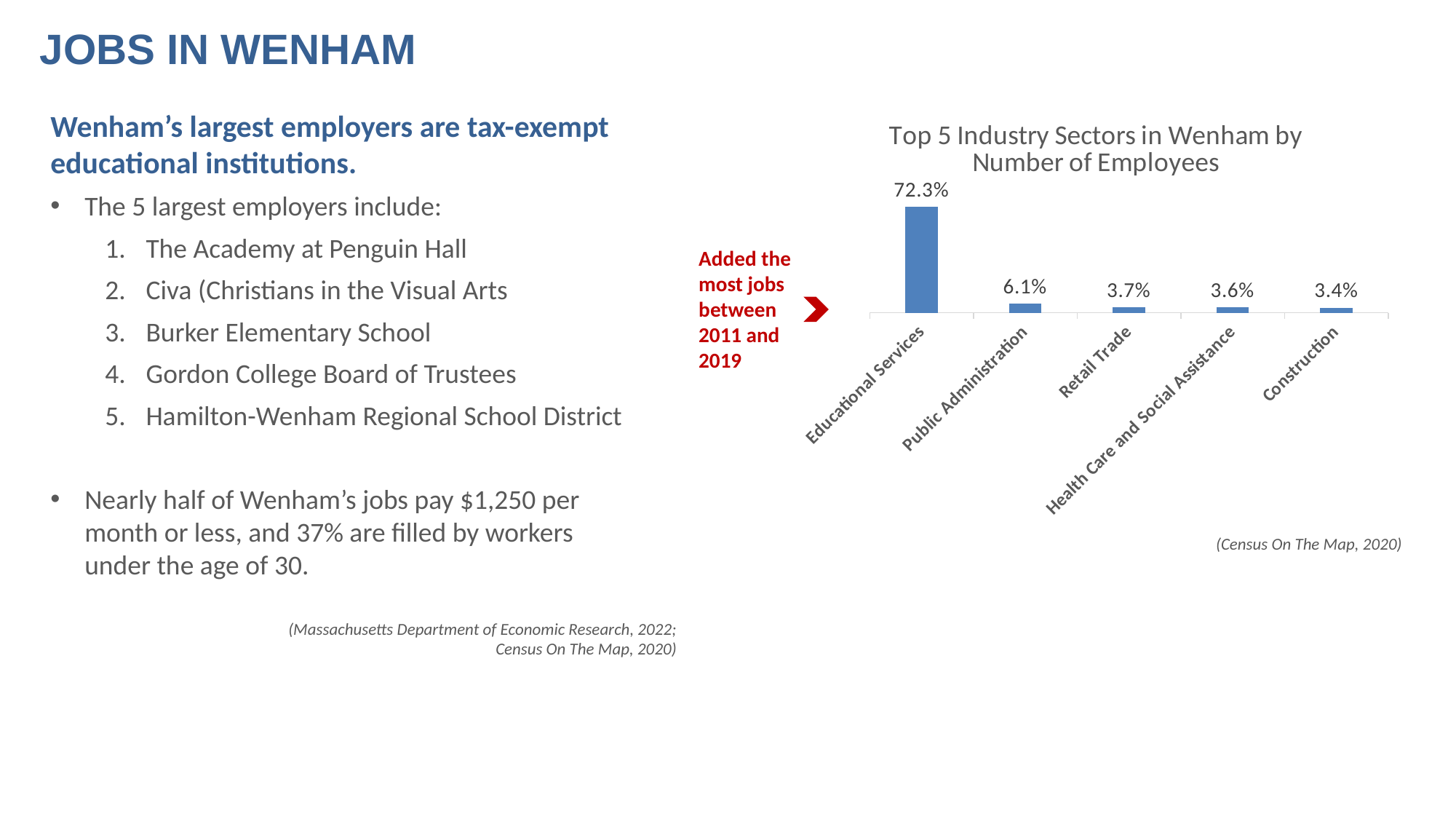
What is the value for Construction? 3.4% How many industry sectors are shown in the chart? 5 What is the value for Educational Services? 72.3% Which industry sector has the lowest share of employees? Construction Which industry sector has the highest share of employees? Educational Services What is the value for Retail Trade? 3.7% What kind of chart is shown on the slide? Bar chart What is the title of the chart? Top 5 Industry Sectors in Wenham by Number of Employees What is the value for Health Care and Social Assistance? 3.6% What is the difference between the values for Educational Services and Public Administration? 66.2% Which is larger, the value for Public Administration or the value for Retail Trade? Public Administration What is the value for Public Administration? 6.1%